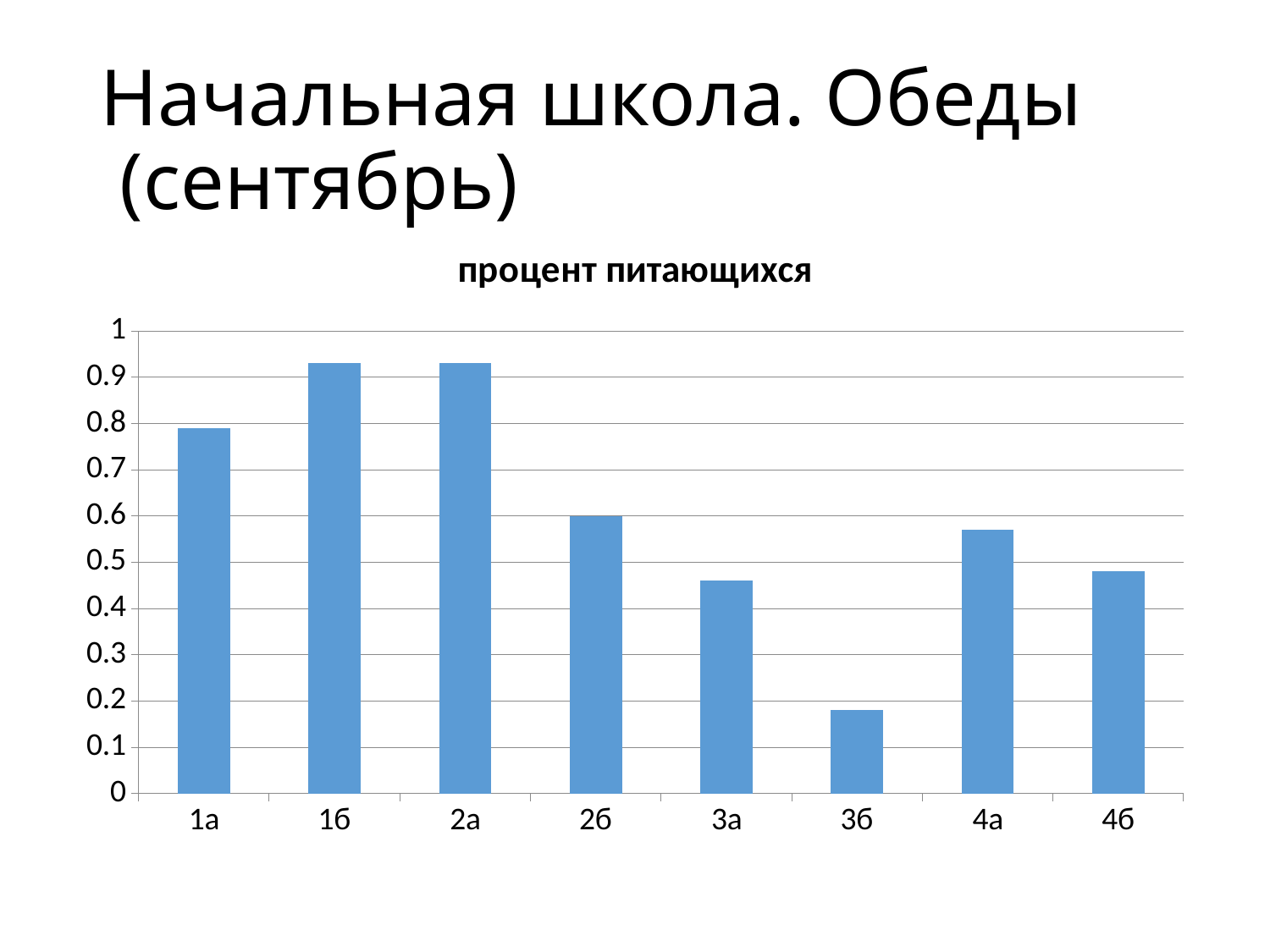
Is the value for class 1а greater or less than 0.7? greater What is the value for class 2б? 0.6 Which class has the larger value, 3б or 4б? 4б Is the value for class 4б greater or less than 0.5? less Which class has the lowest value in the chart? 3б Which class has the larger value, 4а or 3а? 4а Which class has the larger value, 1а or 2б? 1а What type of chart is shown on the slide? bar chart Is the value for class 1б greater or less than 0.9? greater What is the title of the chart? процент питающихся How many classes (categories) are shown on the x axis of the chart? 8